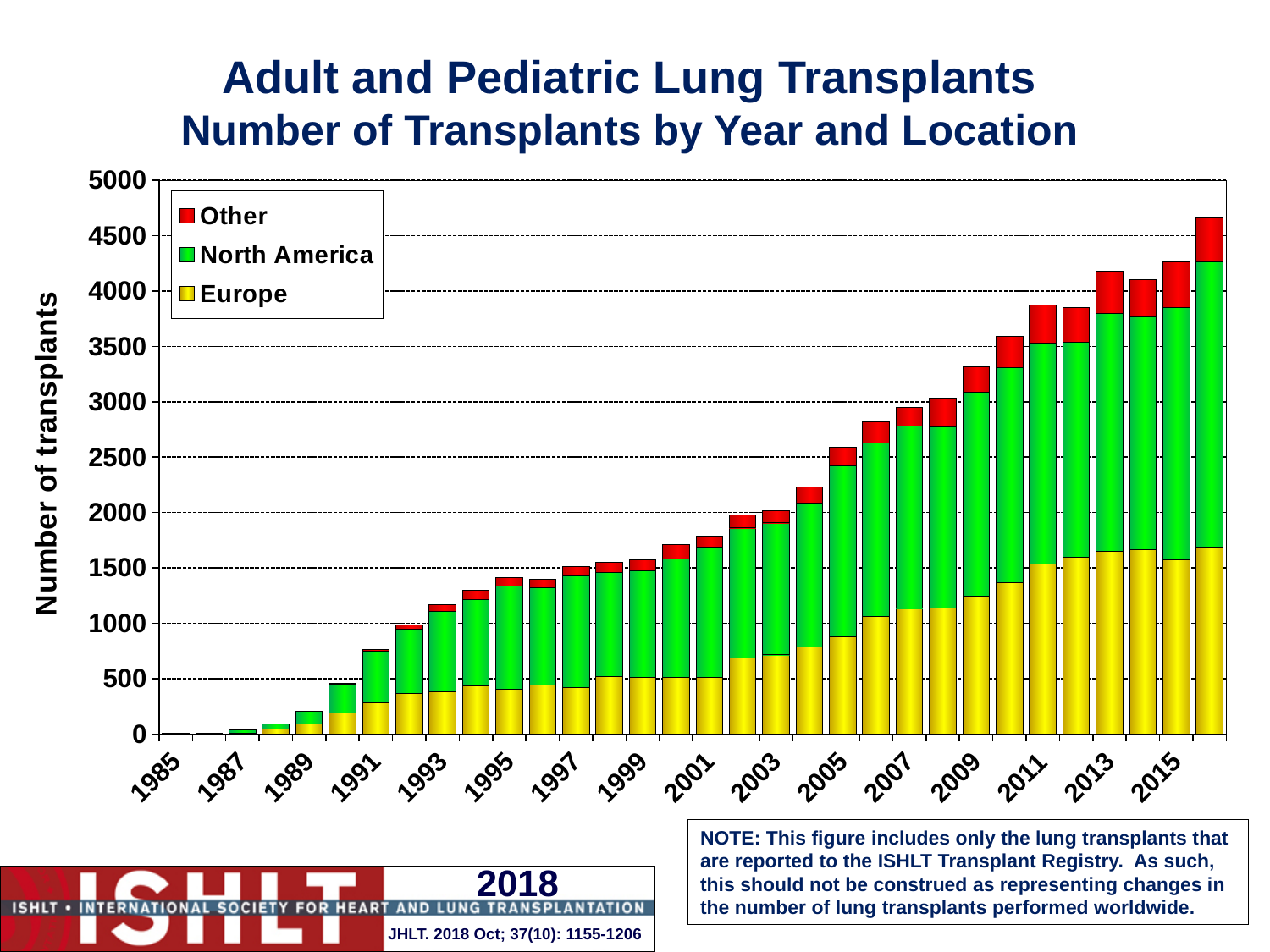
How many series does the legend list? 3 What kind of chart is shown on the slide? stacked bar chart Which year had more total transplants, 2003 or 2005? 2005 What colour represents Europe in the chart? yellow Is the total number of transplants in 2015 greater or less than 4000? greater Which year had more total transplants, 2011 or 2013? 2013 Overall, do the total number of transplants rise or fall from 1985 to the last year shown? rise Is the total number of transplants in 2005 greater or less than 2500? greater Which three regions are listed in the legend? Other, North America, Europe Is the total number of transplants in 2011 greater or less than 4000? less